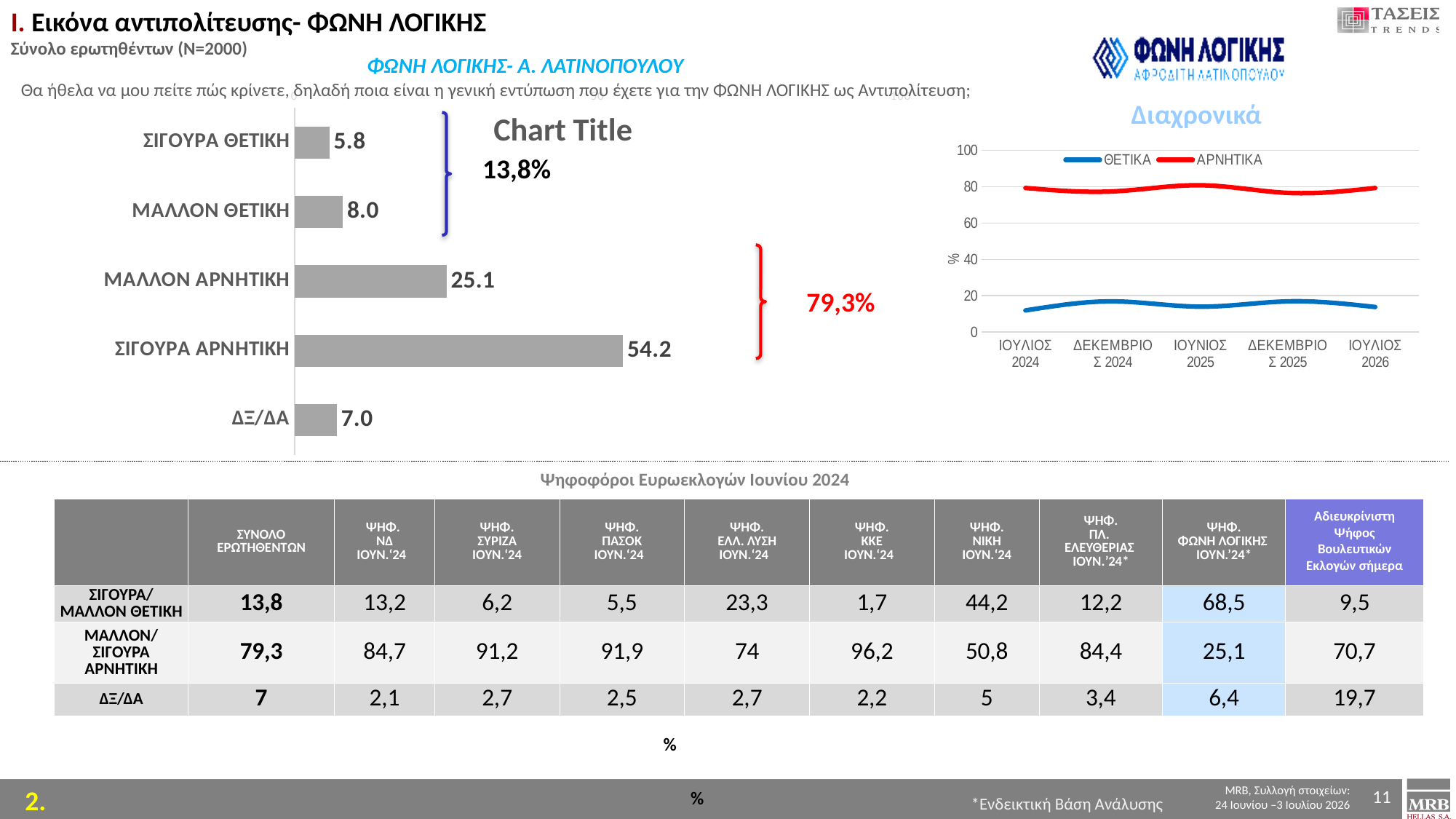
In the Διαχρονικά chart, is the value of ΘΕΤΙΚΑ for ΙΟΥΛΙΟΣ 2024 greater or less than 20? less In the bar chart on the left, what is the difference between ΣΙΓΟΥΡΑ ΑΡΝΗΤΙΚΗ and ΜΑΛΛΟΝ ΑΡΝΗΤΙΚΗ? 29.1 What kind of chart is the chart on the left? bar chart In the bar chart on the left, which category has the highest value? ΣΙΓΟΥΡΑ ΑΡΝΗΤΙΚΗ How many categories does the bar chart on the left show? 5 In the Διαχρονικά chart, is the value of ΑΡΝΗΤΙΚΑ for ΙΟΥΛΙΟΣ 2026 greater or less than 60? greater In the bar chart on the left, which is larger: ΜΑΛΛΟΝ ΘΕΤΙΚΗ or ΔΞ/ΔΑ? ΜΑΛΛΟΝ ΘΕΤΙΚΗ In the bar chart on the left, what is the value for ΜΑΛΛΟΝ ΘΕΤΙΚΗ? 8.0 In the bar chart on the left, which category has the lowest value? ΣΙΓΟΥΡΑ ΘΕΤΙΚΗ How many series does the legend of the Διαχρονικά chart list? 2 In the bar chart on the left, what is the value for ΣΙΓΟΥΡΑ ΑΡΝΗΤΙΚΗ? 54.2 In the Διαχρονικά chart, which series is drawn in red? ΑΡΝΗΤΙΚΑ